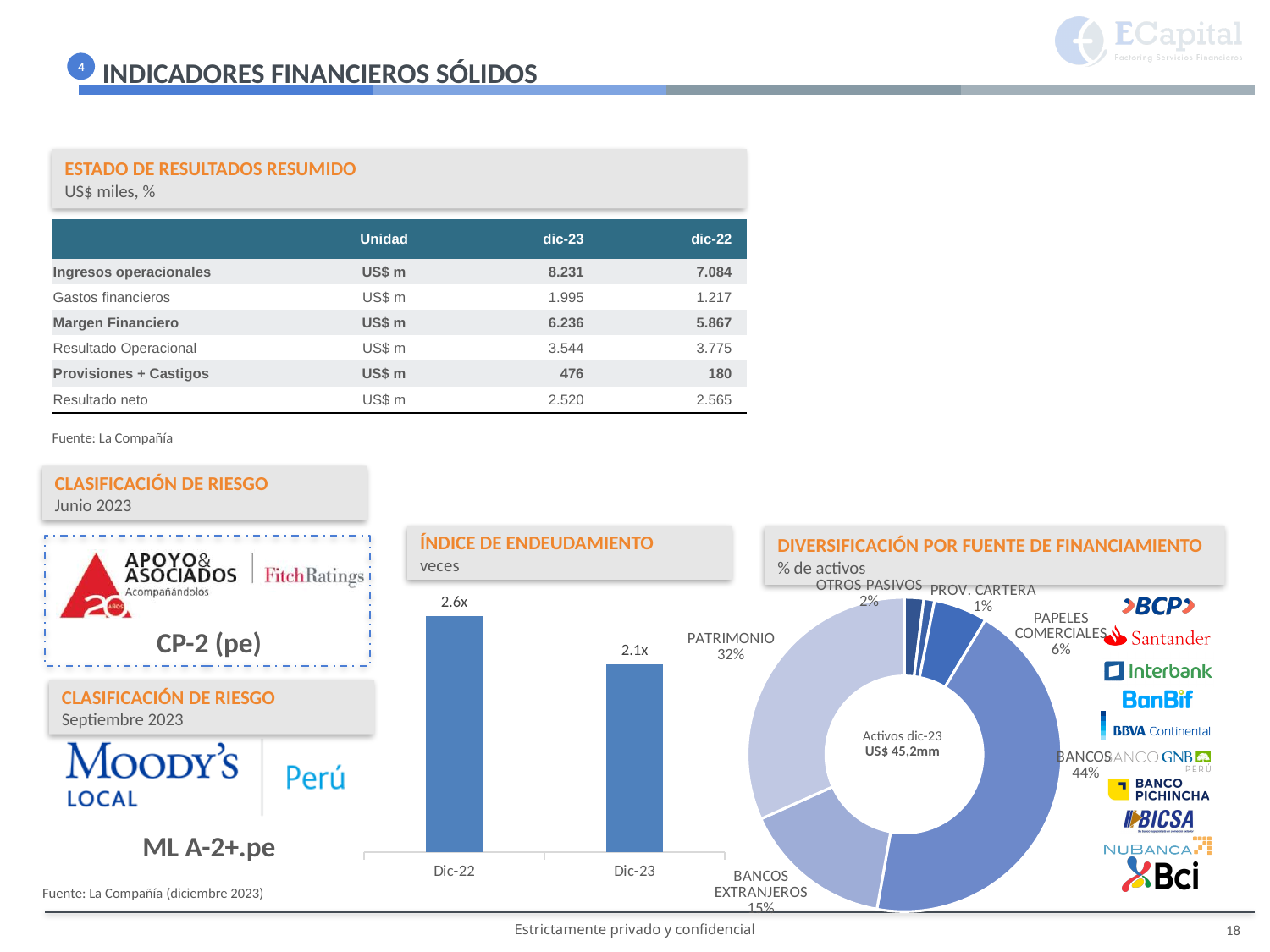
In the ÍNDICE DE ENDEUDAMIENTO chart, how many bars are plotted? 2 What total assets figure is shown in the centre of the DIVERSIFICACIÓN POR FUENTE DE FINANCIAMIENTO chart? US$ 45,2mm In the ÍNDICE DE ENDEUDAMIENTO chart, what is the value for Dic-23? 2.1x In the DIVERSIFICACIÓN POR FUENTE DE FINANCIAMIENTO chart, which is larger: BANCOS EXTRANJEROS or PAPELES COMERCIALES? BANCOS EXTRANJEROS In the DIVERSIFICACIÓN POR FUENTE DE FINANCIAMIENTO chart, what is the difference in percentage points between BANCOS and PATRIMONIO? 12 In the DIVERSIFICACIÓN POR FUENTE DE FINANCIAMIENTO chart, what share does PATRIMONIO represent? 32% In the DIVERSIFICACIÓN POR FUENTE DE FINANCIAMIENTO chart, which source has the smallest share? PROV. CARTERA In the DIVERSIFICACIÓN POR FUENTE DE FINANCIAMIENTO chart, what share do BANCOS represent? 44% In the ÍNDICE DE ENDEUDAMIENTO chart, which period has the higher value? Dic-22 What kind of chart is the ÍNDICE DE ENDEUDAMIENTO chart? bar chart In the ÍNDICE DE ENDEUDAMIENTO chart, what is the value for Dic-22? 2.6x In the ÍNDICE DE ENDEUDAMIENTO chart, does the value rise or fall from Dic-22 to Dic-23? fall